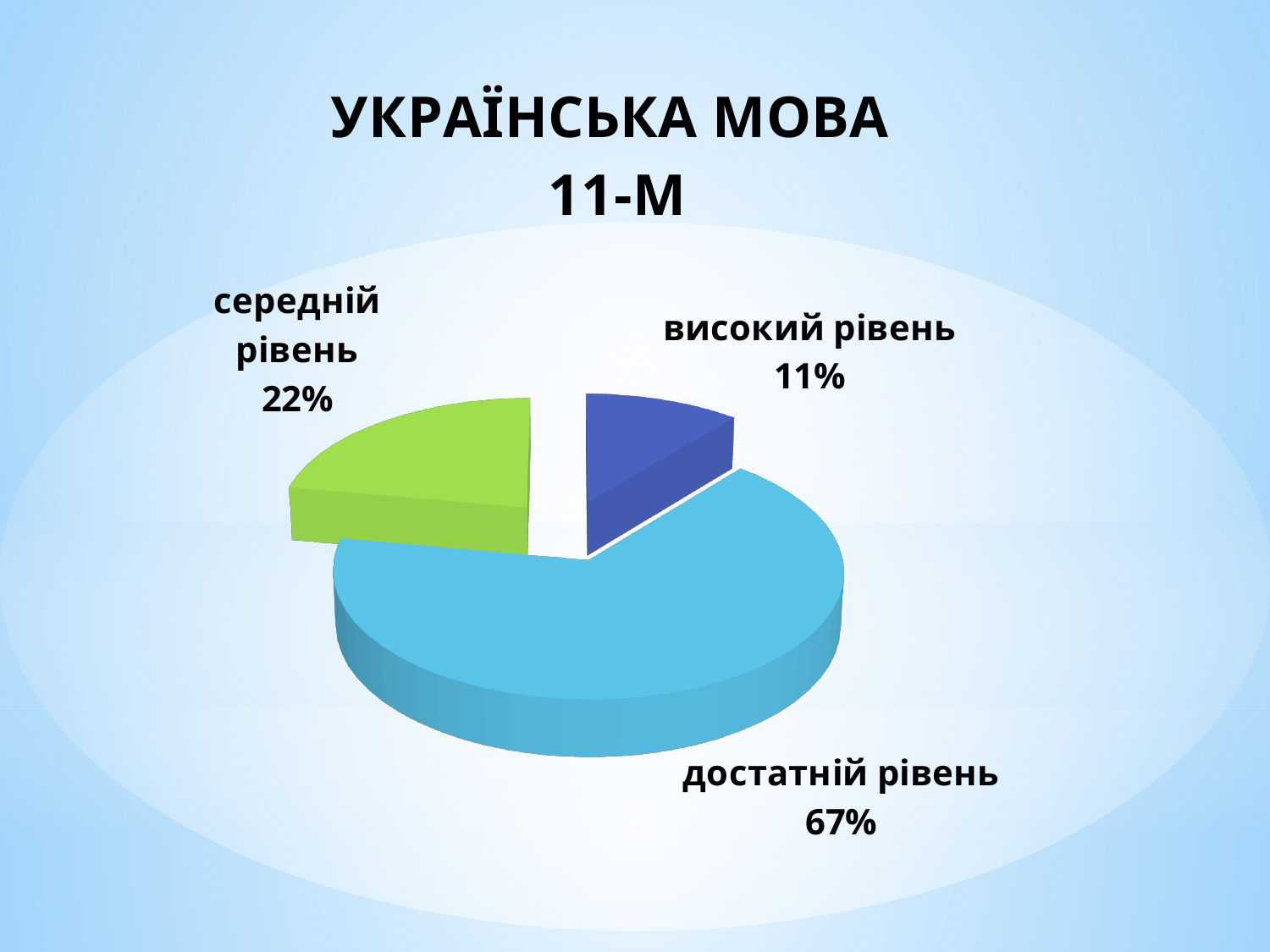
What colour is the slice for "середній рівень"? green What is the difference between the shares of "середній рівень" and "високий рівень"? 11% What share of the pie does the "достатній рівень" slice represent? 67% What kind of chart is shown on the slide? pie chart What is the title of the chart? УКРАЇНСЬКА МОВА 11-М How many categories are shown in the pie chart? 3 What is the difference between the shares of "достатній рівень" and "середній рівень"? 45% What is the value shown for "середній рівень"? 22% Which category has the largest slice of the pie? достатній рівень What is the value shown for "високий рівень"? 11% Which category has the smallest slice of the pie? високий рівень Which is larger, the share for "середній рівень" or the share for "високий рівень"? середній рівень